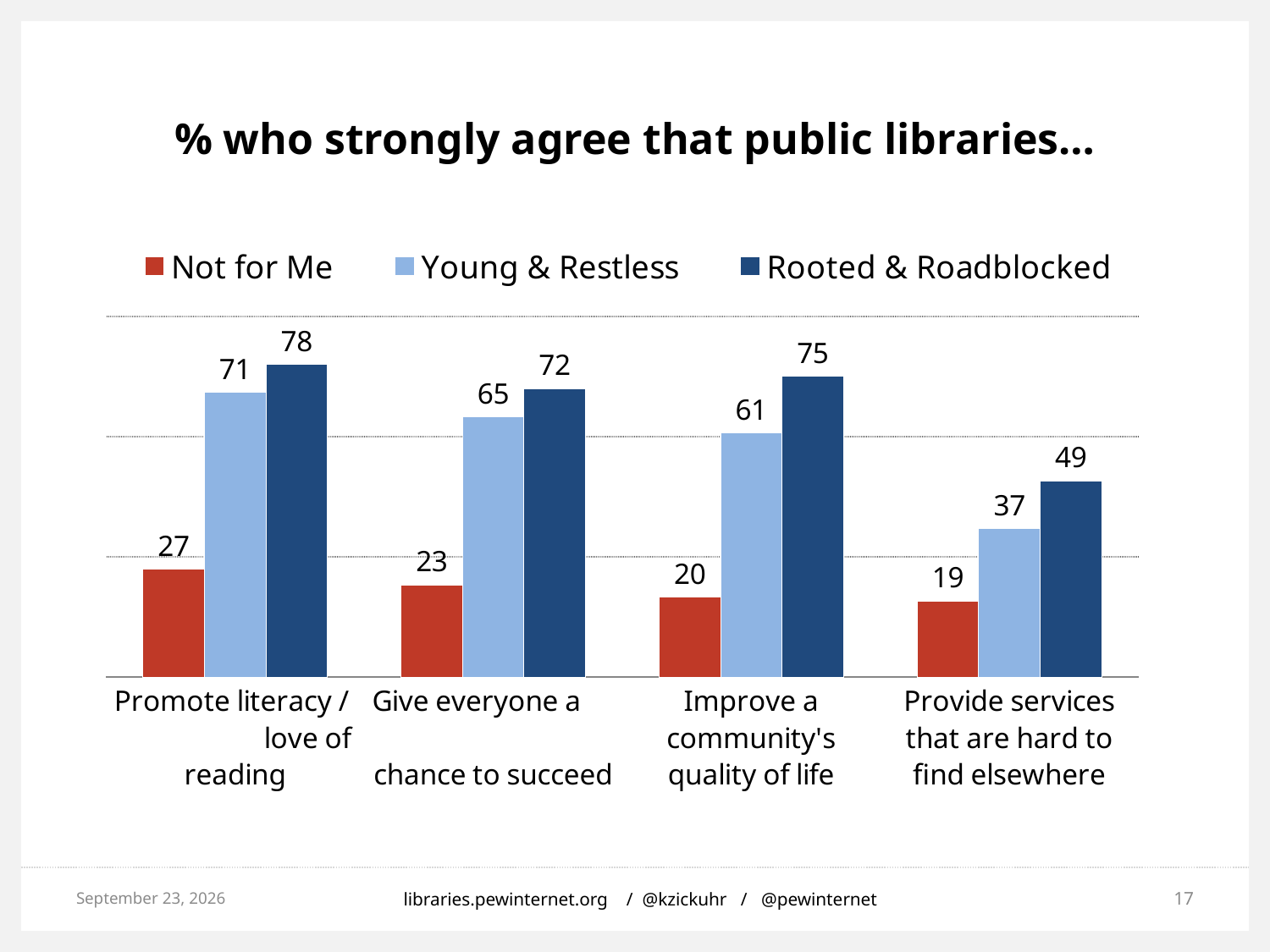
Do the Rooted & Roadblocked values rise or fall from the first category to the last? Fall What is the difference between Rooted & Roadblocked and Not for Me for "Give everyone a chance to succeed"? 49 For "Improve a community's quality of life", which is larger: Young & Restless or Rooted & Roadblocked? Rooted & Roadblocked Which category has the highest value for Young & Restless? Promote literacy / love of reading Which category has the lowest value for Not for Me? Provide services that are hard to find elsewhere What is the value for Not for Me for "Improve a community's quality of life"? 20 What is the value for Rooted & Roadblocked for "Promote literacy / love of reading"? 78 How many series does the legend list? 3 What is the title of the chart? % who strongly agree that public libraries… What is the value for Young & Restless for "Provide services that are hard to find elsewhere"? 37 What kind of chart is shown on the slide? Bar chart How many categories are shown on the x axis? 4